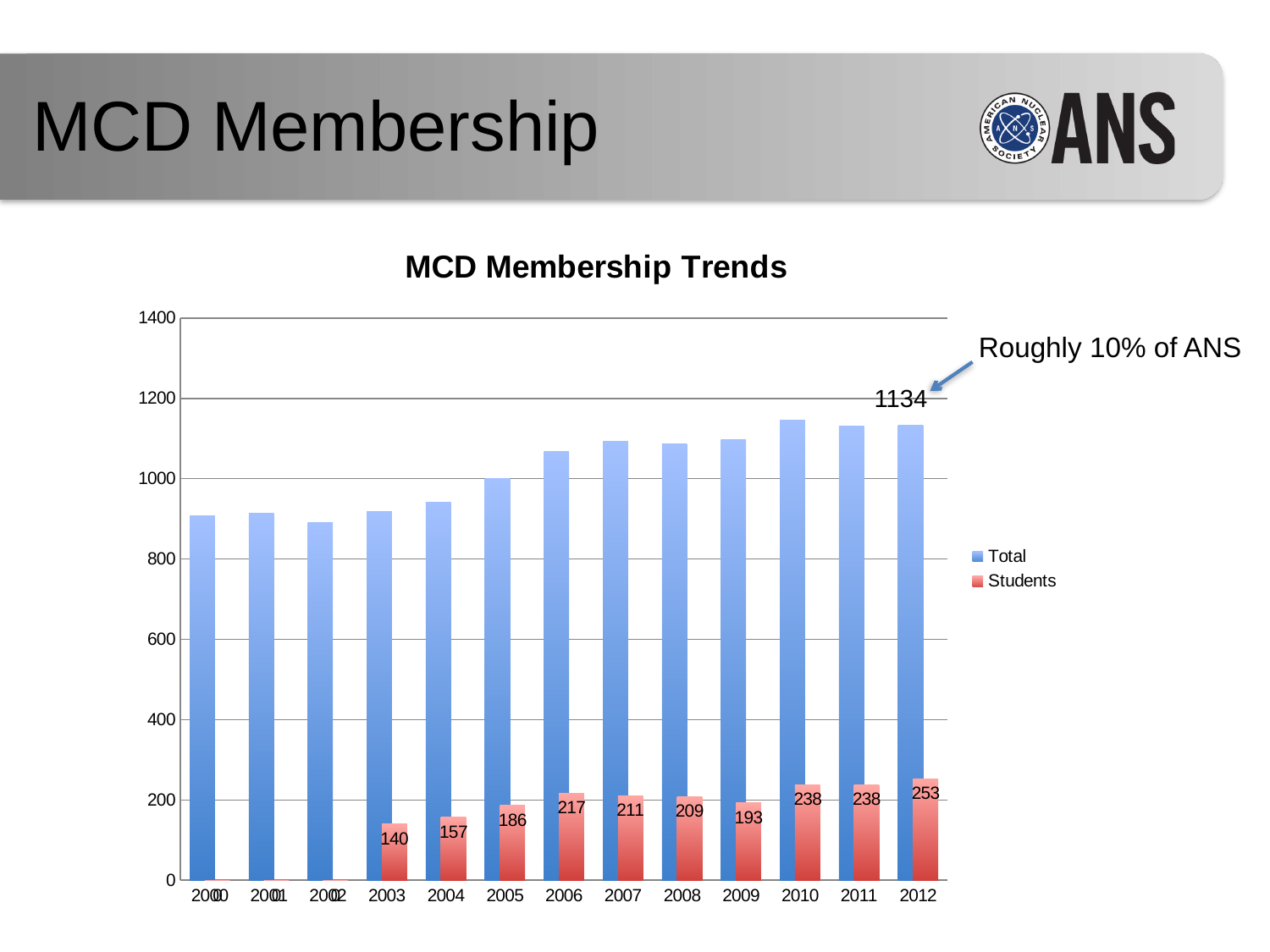
What is the difference between the Students values for 2012 and 2011? 15 Is the Total value for 2000 greater or less than 1000? less What is the Students value for 2009? 193 What is the Total value for 2012? 1134 What kind of chart is shown? bar chart How many series does the legend list? 2 How many years are shown on the x axis? 13 Which year has the highest Students value? 2012 What is the Students value for 2003? 140 Is the Total value for 2010 greater or less than 1000? greater Which is larger, the Students value for 2006 or for 2007? 2006 What is the Students value for 2012? 253